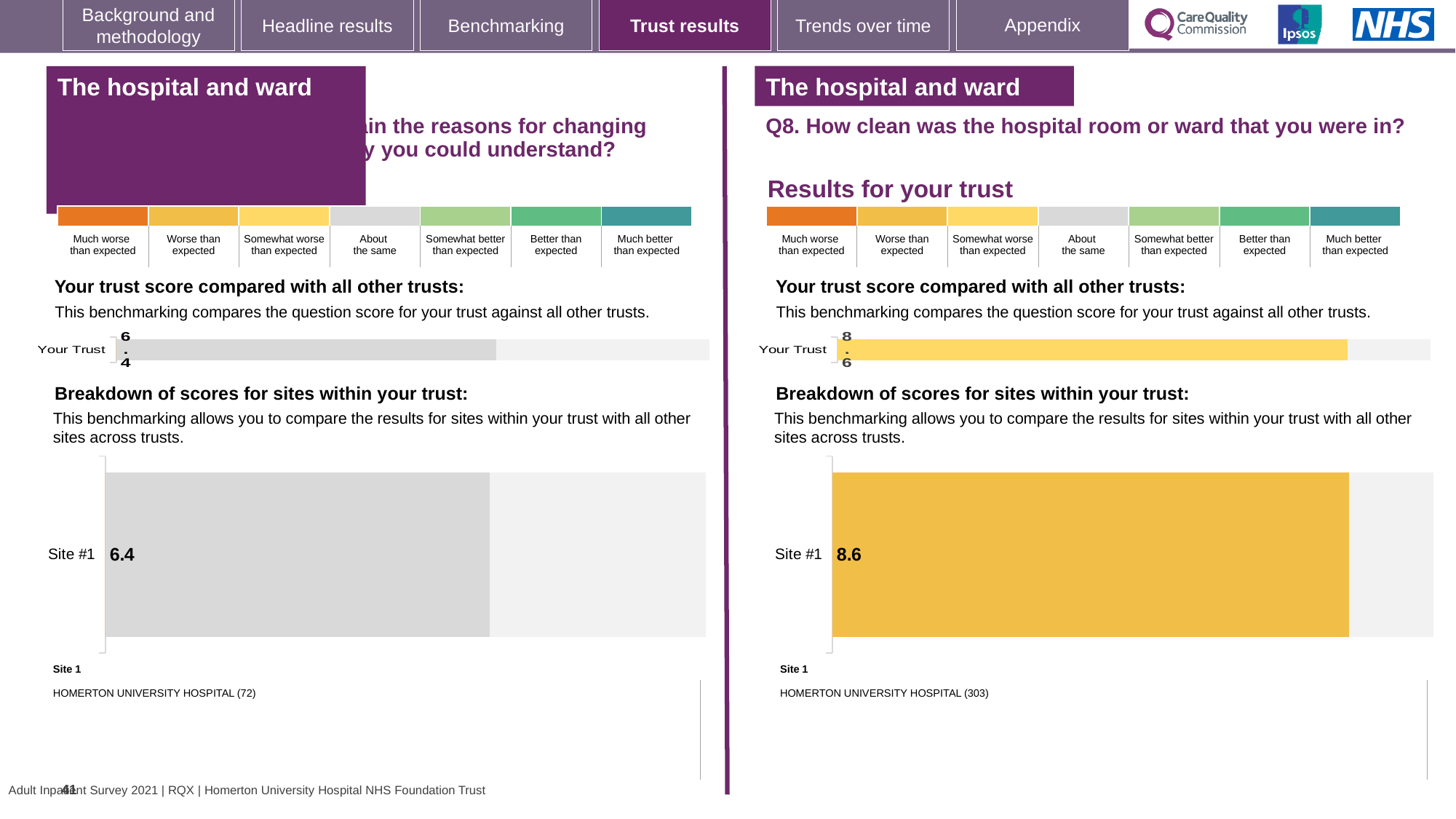
According to the colour key, which benchmark category does the yellow Your Trust bar on the right-hand Q8 chart correspond to? Somewhat worse than expected According to the colour key, which benchmark category does the grey Your Trust bar on the left-hand chart correspond to? About the same On the left-hand chart, what is the score shown for Your Trust? 6.4 In the right-hand breakdown of scores for sites within your trust (Q8), what is the score for Site #1? 8.6 How many sites are shown in the right-hand breakdown of scores for sites within your trust? 1 How many benchmark categories are shown in the colour key above the right-hand Q8 chart? 7 On the right-hand chart for Q8 (how clean was the hospital room or ward), what is the score shown for Your Trust? 8.6 On the right-hand Q8 chart, is the Site #1 score greater or less than 8? greater What is the difference between the Site #1 score on the right-hand Q8 chart and the Site #1 score on the left-hand chart? 2.2 What kind of chart is used to show the Your Trust score on each half of the slide? Bar chart Which is larger: the Your Trust score on the left-hand chart or the Your Trust score on the right-hand Q8 chart? The right-hand Q8 chart (8.6) In the left-hand breakdown of scores for sites within your trust, what is the score for Site #1? 6.4